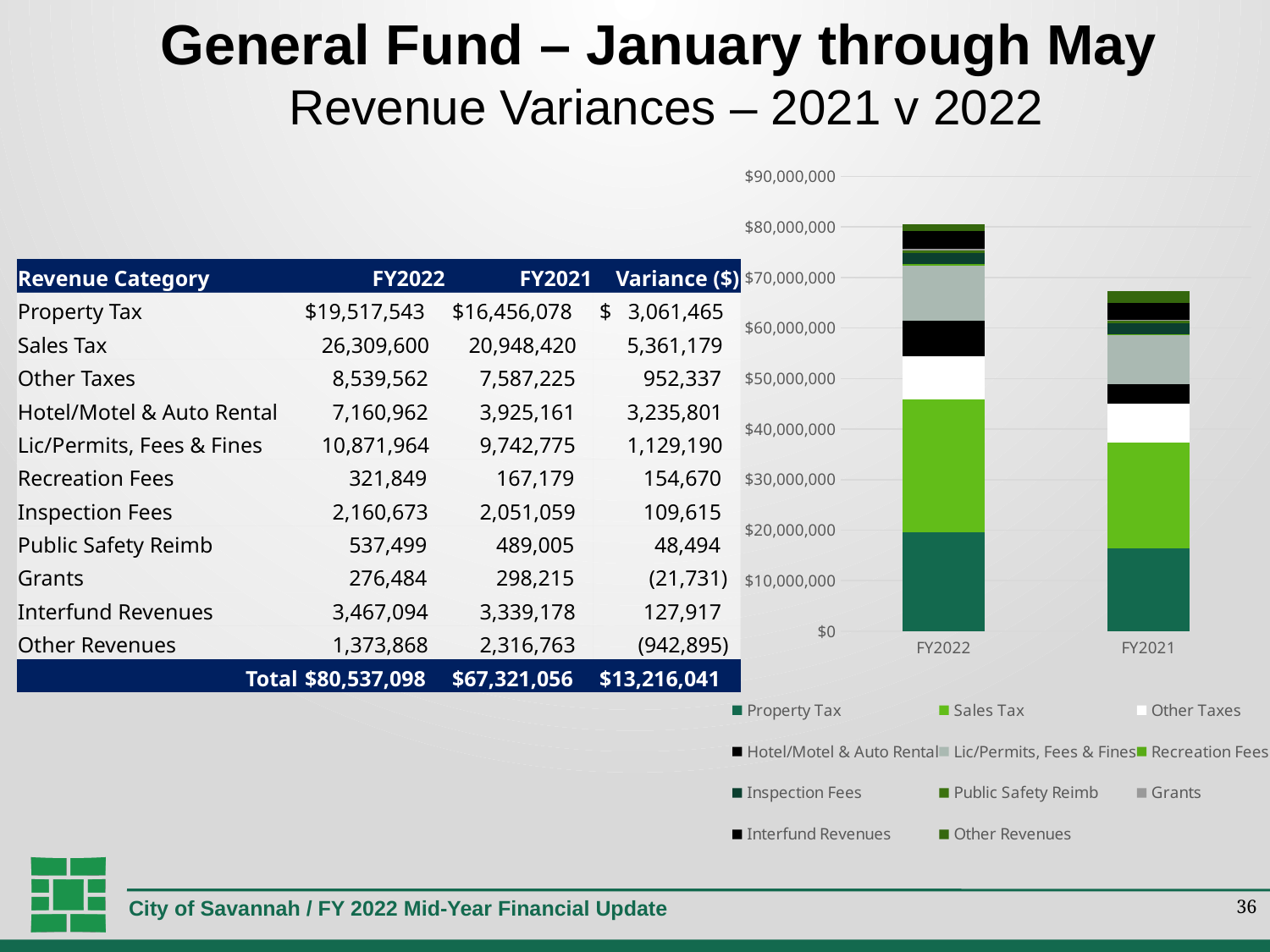
What is the Sales Tax value for FY2022 shown in the table? 26,309,600 How many bars (fiscal years) are plotted on the x axis of the chart? 2 Which stacked bar is taller, FY2022 or FY2021? FY2022 What is the total of the FY2021 stacked bar, as shown in the table's Total row? $67,321,056 What is the total of the FY2022 stacked bar, as shown in the table's Total row? $80,537,098 Is the total height of the FY2021 stacked bar greater or less than $70,000,000? less What kind of chart is shown on the right of the slide? bar chart Is the total height of the FY2022 stacked bar greater or less than $70,000,000? greater Which series forms the bottom segment of each stacked bar in the chart? Property Tax What is the variance between FY2022 and FY2021 for Property Tax, as printed in the table? $ 3,061,465 Is the Property Tax segment of the FY2022 bar greater or less than $10,000,000? greater How many series does the chart's legend list? 11